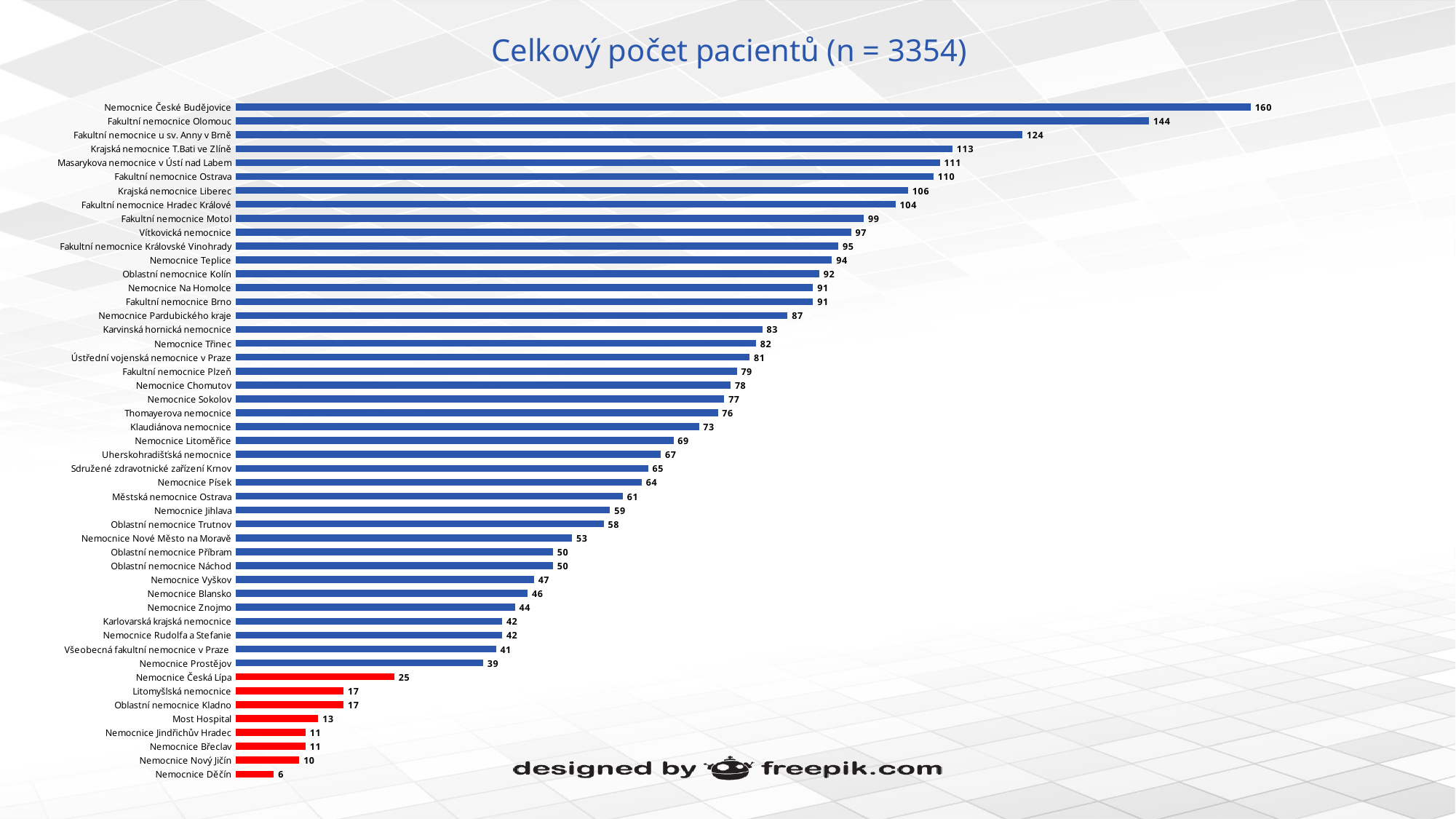
Which hospital has the highest number of patients? Nemocnice České Budějovice How many hospitals are shown in the chart? 49 What is the value for Fakultní nemocnice Motol? 99 What is the value for Nemocnice Česká Lípa? 25 What is the difference between Fakultní nemocnice Olomouc and Fakultní nemocnice u sv. Anny v Brně? 20 Which is larger, the value for Nemocnice Teplice or the value for Oblastní nemocnice Kolín? Nemocnice Teplice What is the difference between Nemocnice Prostějov and Nemocnice Česká Lípa? 14 What is the value for Nemocnice České Budějovice? 160 How many bars are coloured red? 8 What kind of chart is shown on the slide? Bar chart What is the title of the chart? Celkový počet pacientů (n = 3354) Which hospital has the lowest number of patients? Nemocnice Děčín